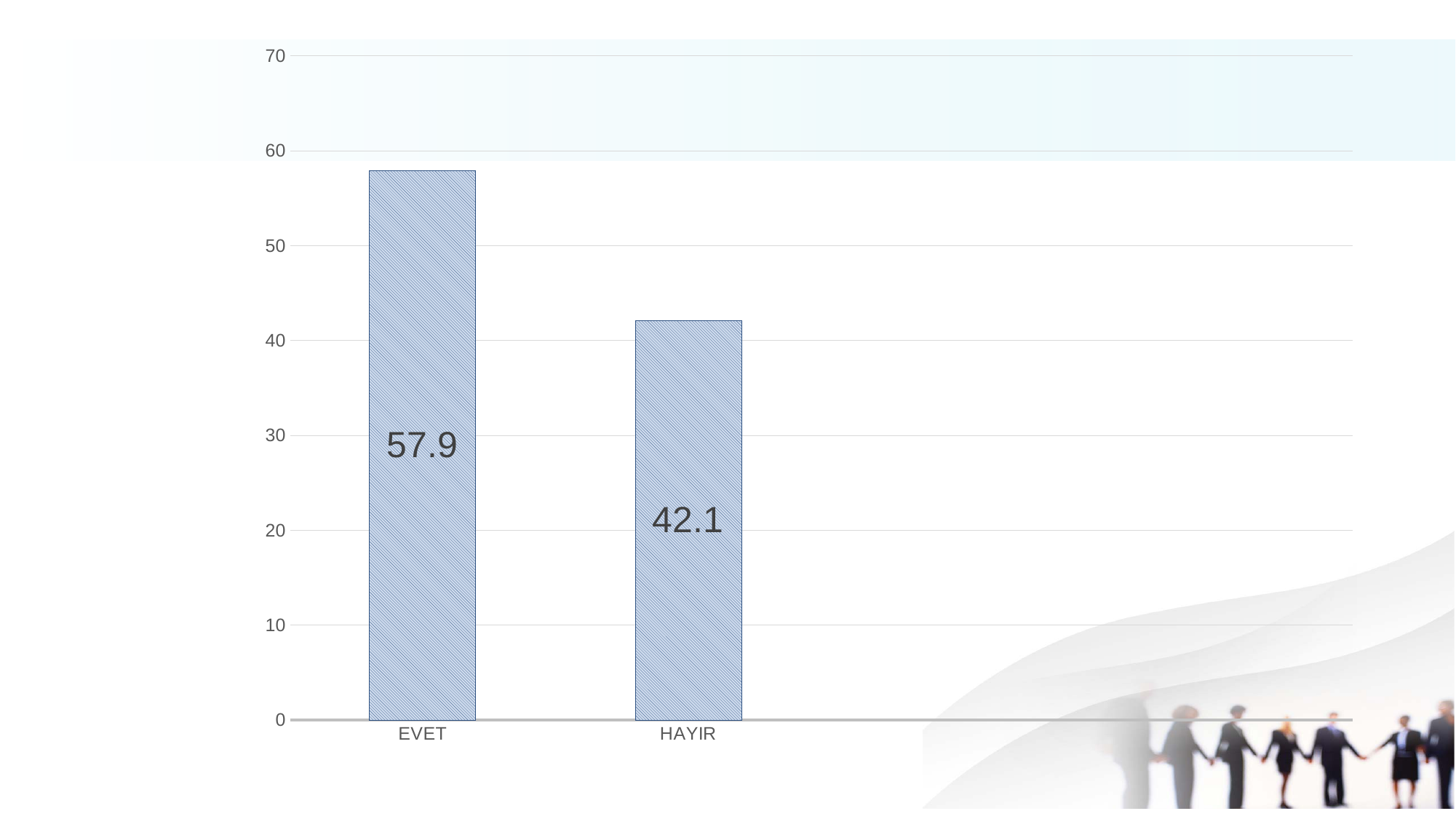
What kind of chart is shown on the slide? bar chart Which category has the lowest value? HAYIR What is the value for HAYIR? 42.1 What is the highest value shown on the vertical axis? 70 Which category has the highest value? EVET Is the value for EVET greater or less than 50? greater What is the difference between the values for EVET and HAYIR? 15.8 How many categories are shown on the x axis? 2 Which is larger, the value for EVET or the value for HAYIR? EVET Is the value for HAYIR greater or less than 50? less What is the total of the two bar values? 100 What is the value for EVET? 57.9